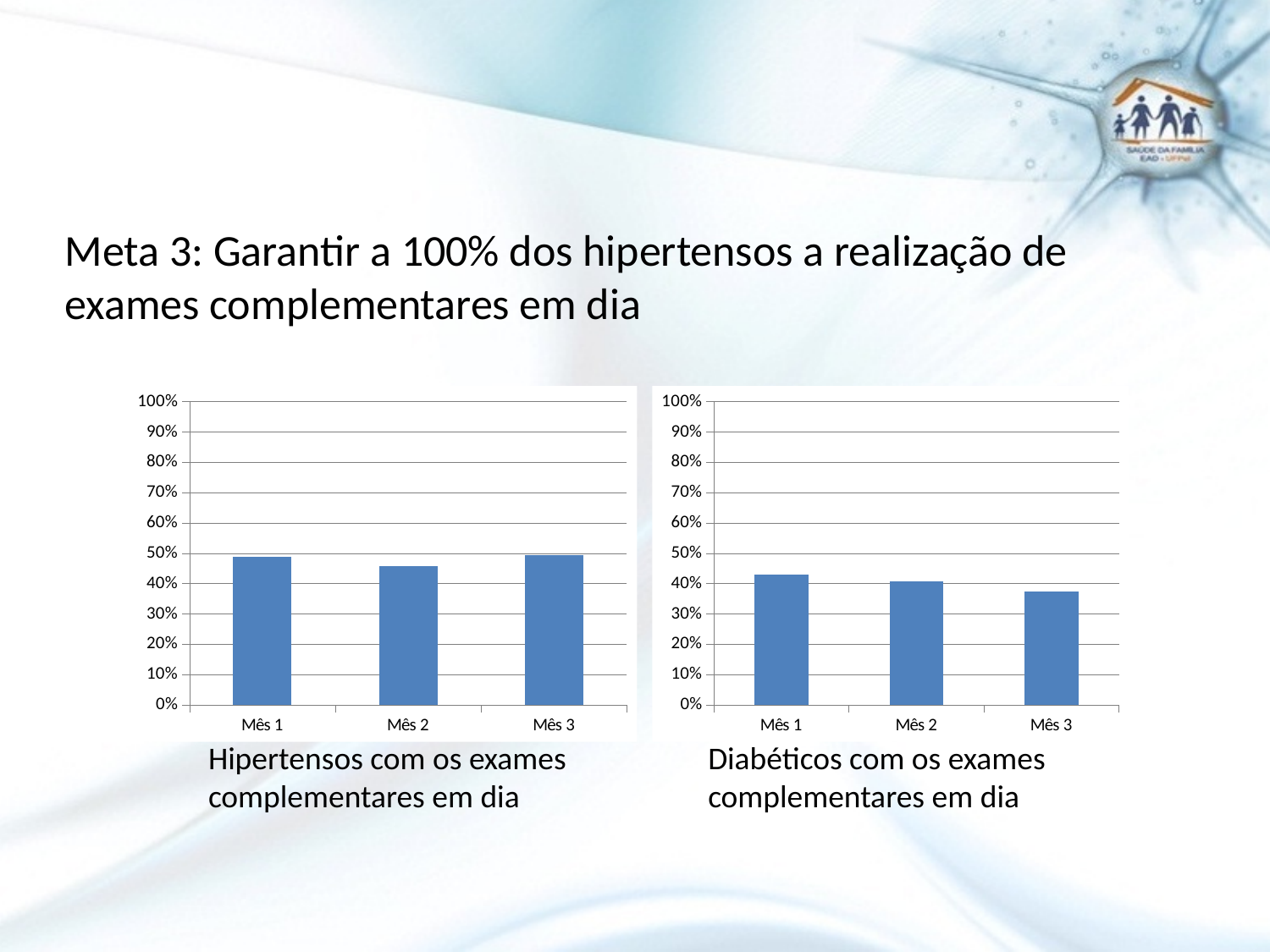
In the chart titled 'Hipertensos com os exames complementares em dia', which month has the lowest value? Mês 2 How many categories are shown on the x axis of the chart titled 'Hipertensos com os exames complementares em dia'? 3 In the chart titled 'Hipertensos com os exames complementares em dia', which is larger, the value for Mês 1 or Mês 2? Mês 1 In the chart titled 'Hipertensos com os exames complementares em dia', is the value for Mês 2 greater or less than 40%? greater In the chart titled 'Diabéticos com os exames complementares em dia', is the value for Mês 3 greater or less than 40%? less What kind of chart is the chart titled 'Diabéticos com os exames complementares em dia'? bar chart In the chart titled 'Diabéticos com os exames complementares em dia', which month has the lowest value? Mês 3 In the chart titled 'Diabéticos com os exames complementares em dia', do the values rise or fall from Mês 1 to Mês 3? fall In the chart titled 'Diabéticos com os exames complementares em dia', which is larger, the value for Mês 1 or Mês 3? Mês 1 In the chart titled 'Diabéticos com os exames complementares em dia', is the value for Mês 1 greater or less than 40%? greater In the chart titled 'Diabéticos com os exames complementares em dia', which month has the highest value? Mês 1